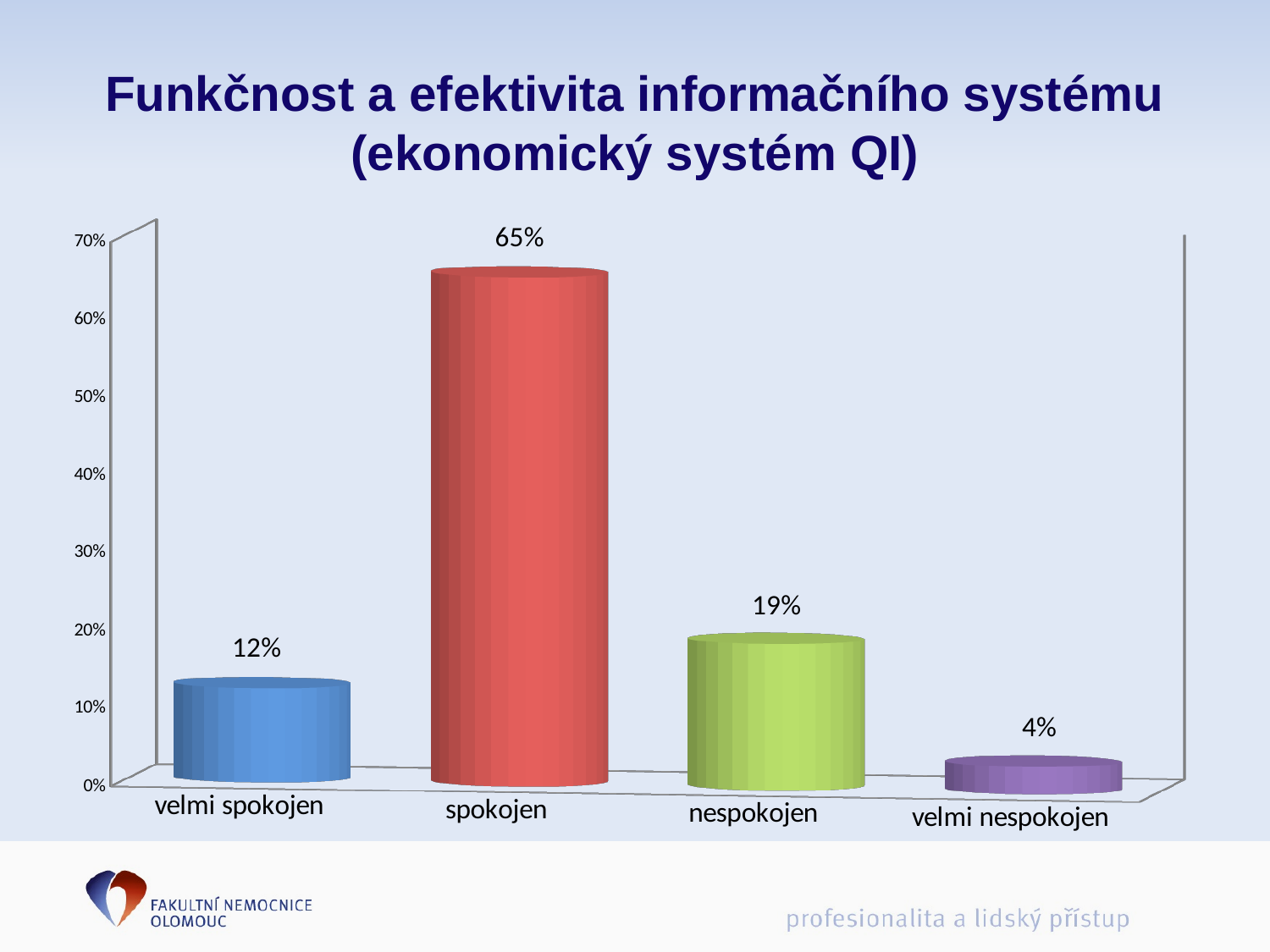
What is the value for "velmi spokojen"? 12% What is the value for "nespokojen"? 19% Which category has the lowest value? velmi nespokojen How many categories are shown on the x axis? 4 What is the difference between the values for "nespokojen" and "velmi spokojen"? 7% What kind of chart is shown on the slide? bar chart What is the value for "velmi nespokojen"? 4% Which category has the highest value? spokojen What is the difference between the values for "spokojen" and "nespokojen"? 46% Which is larger, the value for "velmi spokojen" or the value for "nespokojen"? nespokojen What is the value for "spokojen"? 65% What colour is the bar for "spokojen"? red